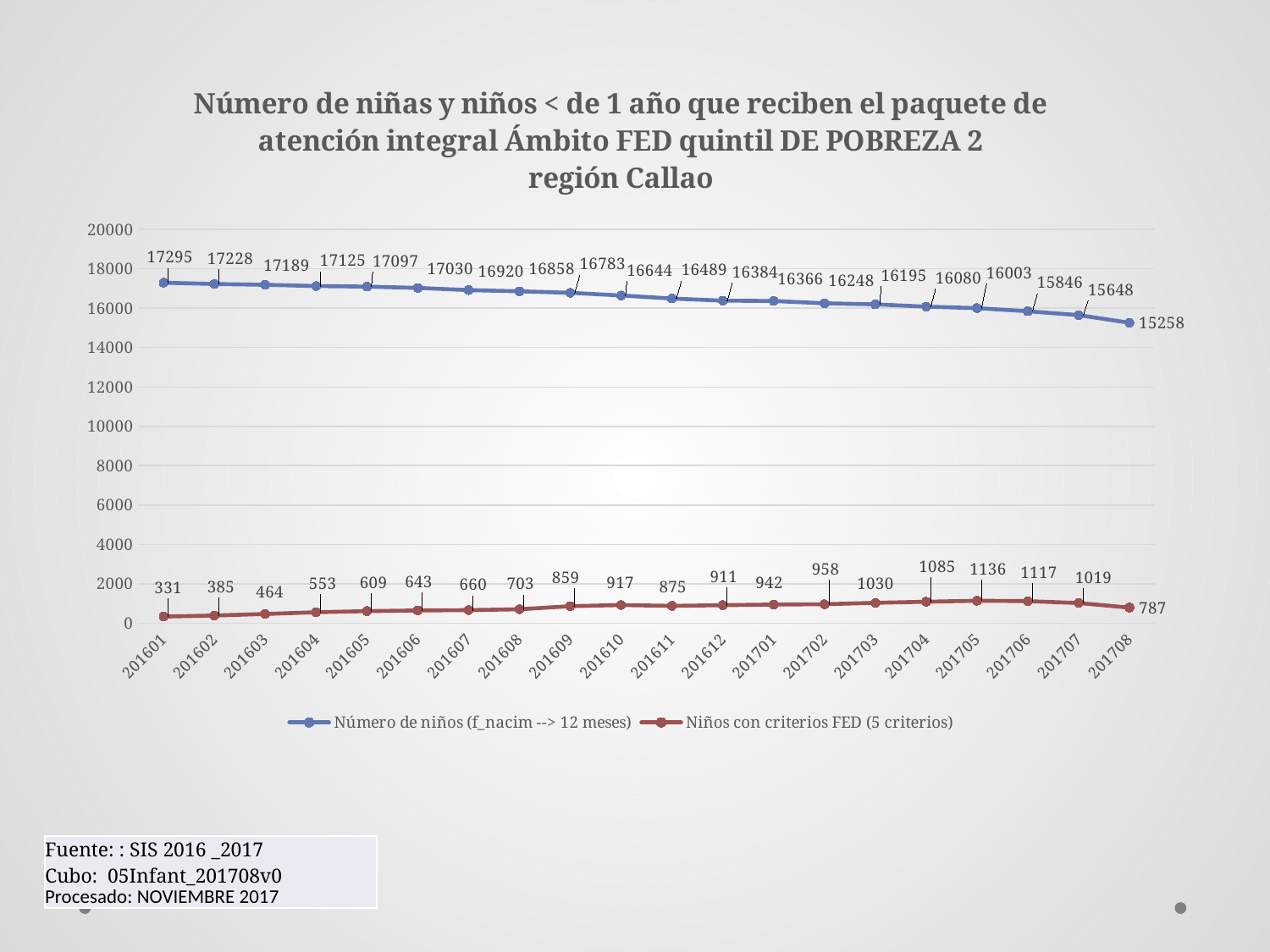
In which period does 'Niños con criterios FED (5 criterios)' have its lowest value? 201601 What is the value of 'Número de niños (f_nacim --> 12 meses)' for 201601? 17295 What is the value of 'Número de niños (f_nacim --> 12 meses)' for 201708? 15258 Is the value of 'Número de niños (f_nacim --> 12 meses)' for 201708 greater or less than 16000? less How many periods are shown on the x axis? 20 In which period does 'Niños con criterios FED (5 criterios)' reach its highest value? 201705 What kind of chart is shown on the slide? line chart How many series does the legend list? 2 What is the difference between the 'Número de niños (f_nacim --> 12 meses)' values for 201601 and 201708? 2037 What is the value of 'Niños con criterios FED (5 criterios)' for 201705? 1136 Does the 'Número de niños (f_nacim --> 12 meses)' series rise or fall from 201601 to 201708? fall Which is larger for 'Niños con criterios FED (5 criterios)': the value for 201610 or the value for 201611? 201610